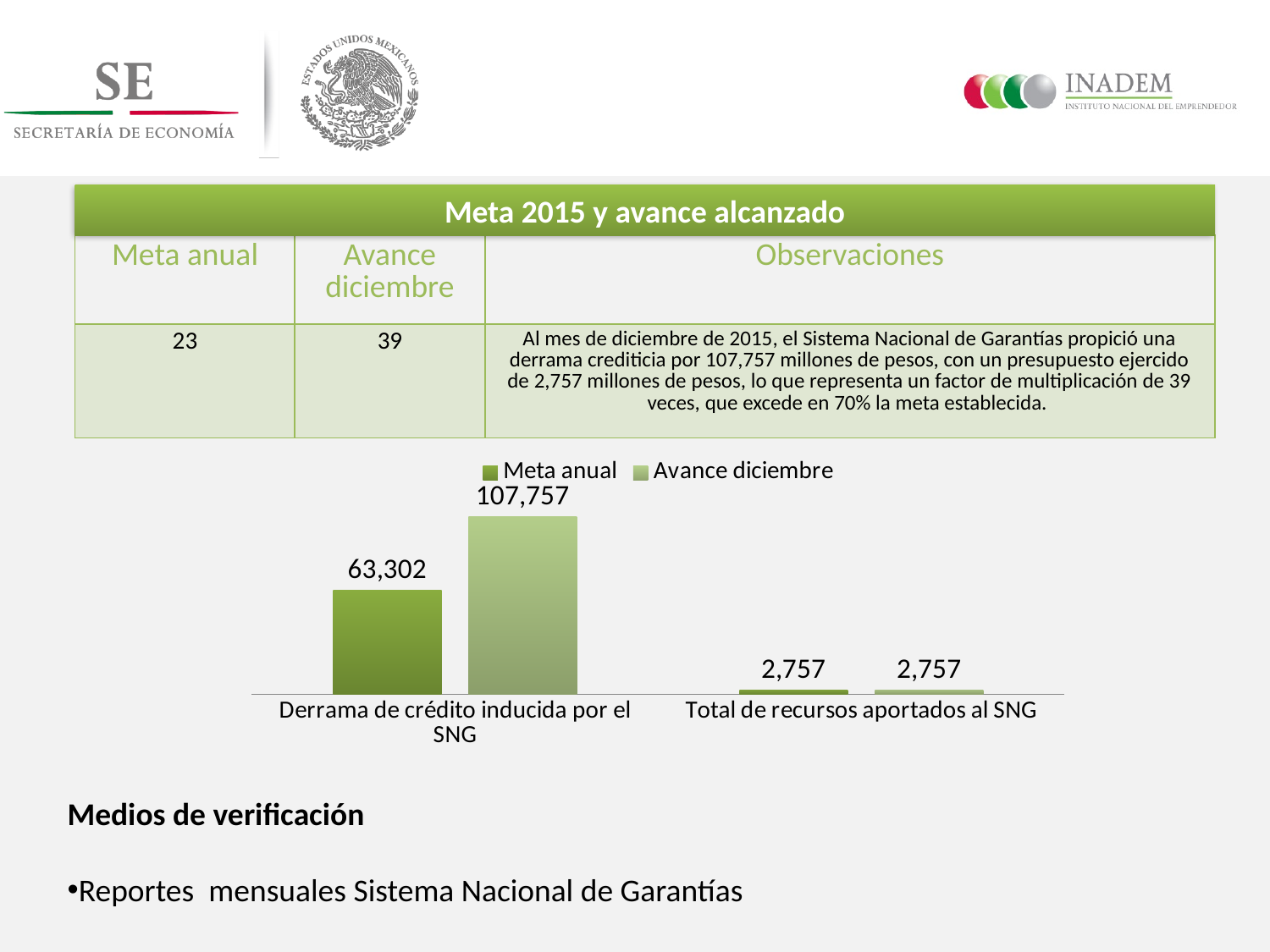
Which bar in the chart has the highest value? Avance diciembre for Derrama de crédito inducida por el SNG What is the difference between the Avance diciembre and Meta anual values for Derrama de crédito inducida por el SNG? 44,455 What kind of chart is shown on the slide? Bar chart What is the Meta anual value for Total de recursos aportados al SNG? 2,757 What is the Avance diciembre value for Total de recursos aportados al SNG? 2,757 How many series does the chart legend list? 2 What is the Avance diciembre value for Derrama de crédito inducida por el SNG? 107,757 What are the two series names listed in the chart legend? Meta anual and Avance diciembre How many categories are shown on the x axis of the chart? 2 What is the Meta anual value for Derrama de crédito inducida por el SNG? 63,302 What is the difference between the Meta anual and Avance diciembre values for Total de recursos aportados al SNG? 0 For Derrama de crédito inducida por el SNG, which is larger: Meta anual or Avance diciembre? Avance diciembre